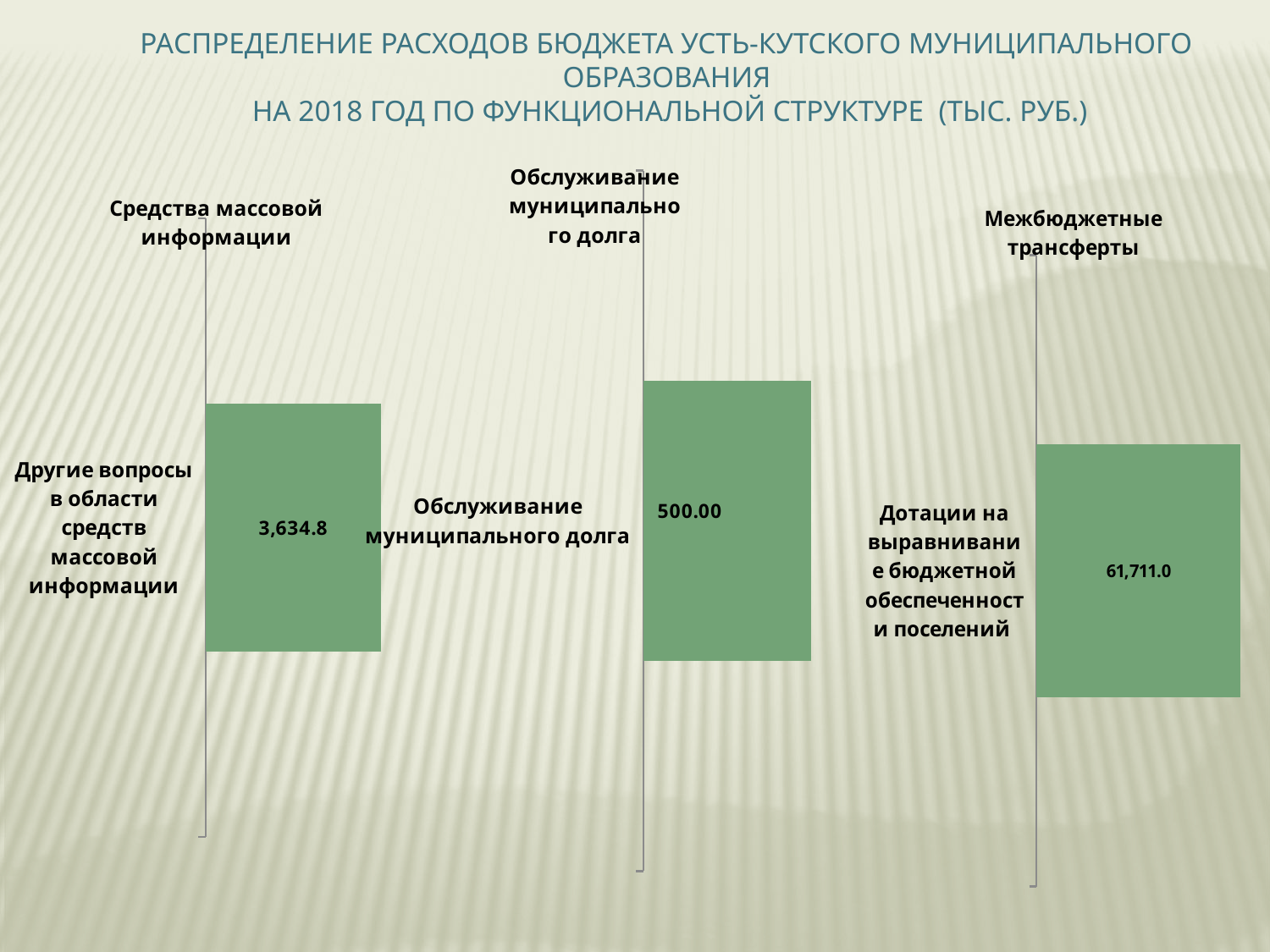
What is the title of the chart on the right side of the slide? Межбюджетные трансферты Which of the three charts on the slide shows the largest value? Межбюджетные трансферты Is the value in the chart titled "Средства массовой информации" larger or smaller than the value in the chart titled "Обслуживание муниципального долга"? larger How many bars are plotted in the chart titled "Обслуживание муниципального долга"? 1 Which of the three charts on the slide shows the smallest value? Обслуживание муниципального долга In the chart titled "Средства массовой информации", what is the value for "Другие вопросы в области средств массовой информации"? 3,634.8 In the chart titled "Обслуживание муниципального долга", what is the value for "Обслуживание муниципального долга"? 500.00 How many bars are plotted in the chart titled "Межбюджетные трансферты"? 1 What colour are the bars in the three charts on the slide? green What is the difference between the value in the chart titled "Средства массовой информации" and the value in the chart titled "Обслуживание муниципального долга"? 3,134.8 What kind of chart is the chart titled "Средства массовой информации"? bar chart In the chart titled "Межбюджетные трансферты", what is the value for "Дотации на выравнивание бюджетной обеспеченности поселений"? 61,711.0